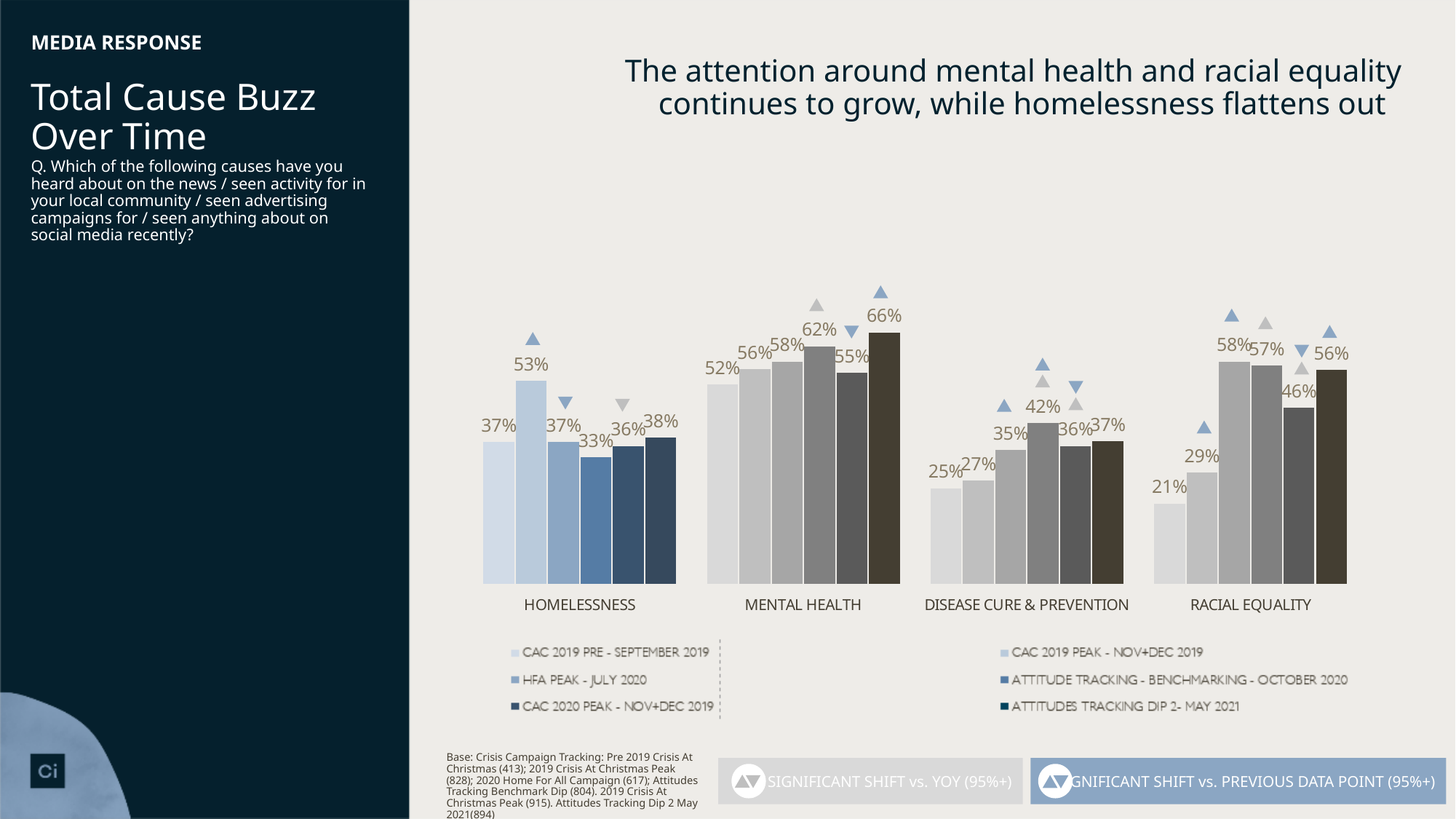
How many series does the legend list? 6 How many cause categories are shown on the x axis? 4 Which is larger: the highest Homelessness value or the highest Disease Cure & Prevention value? Homelessness (53%) What is the value of the last bar (Attitudes Tracking Dip 2 - May 2021) for Mental Health? 66% What is the value of the second bar (CAC 2019 Peak - Nov+Dec 2019) for Homelessness? 53% What is the difference between the last bar (56%) and the first bar (21%) for Racial Equality? 35 percentage points What is the lowest value shown for Disease Cure & Prevention? 25% What is the headline statement above the chart? The attention around mental health and racial equality continues to grow, while homelessness flattens out What kind of chart is shown on the slide? Bar chart What is the value of the first bar (CAC 2019 Pre - September 2019) for Racial Equality? 21% What is the highest value shown for Mental Health? 66% Do the Mental Health values generally rise or fall from the first bar to the last bar? Rise